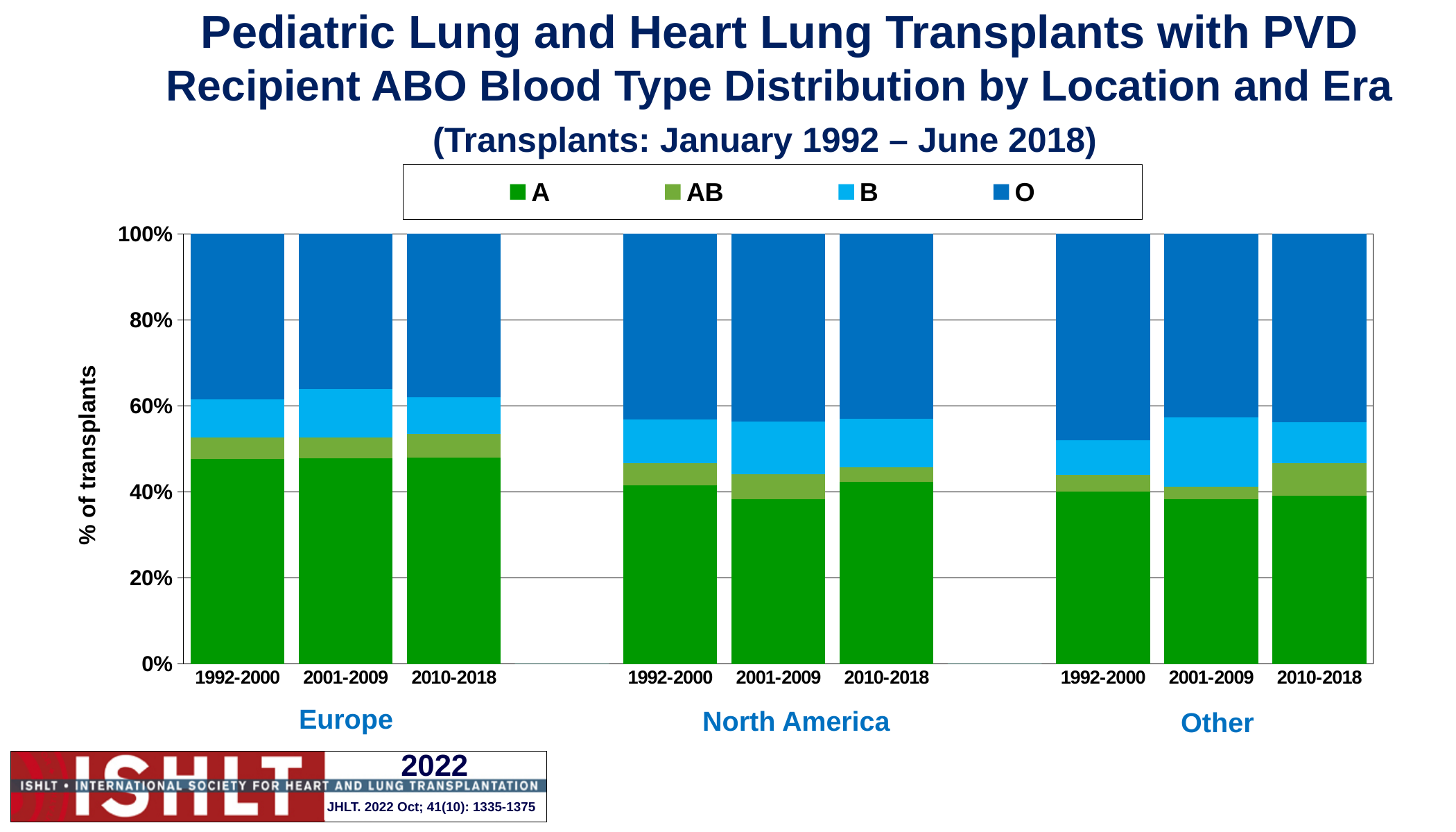
Is the combined share of blood types A, AB and B for Europe in 2001-2009 greater or less than 60%? greater Is the share of blood type A for Europe in 1992-2000 greater or less than 40%? greater Is the share of blood type A for North America in 2001-2009 greater or less than 40%? less What kind of chart is shown on the slide? Stacked bar chart What is the label on the y axis of the chart? % of transplants How many series does the legend list? 4 Which location has the largest share of blood type A in 2010-2018? Europe How many location groups are shown along the x axis? 3 Which is larger: the share of blood type A for Europe in 1992-2000 or for North America in 2001-2009? Europe in 1992-2000 How many bars are plotted in the chart? 9